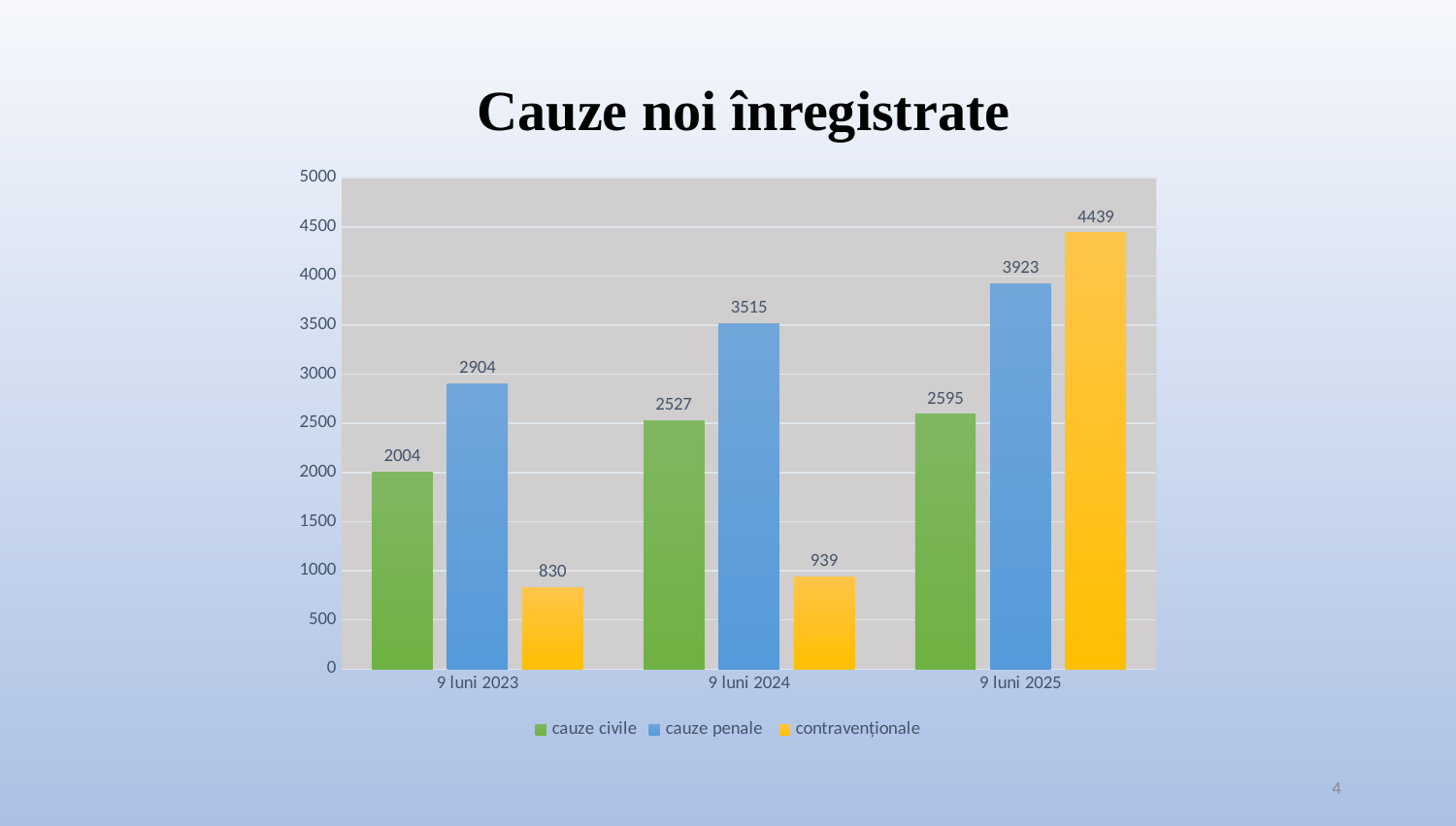
How many periods are shown on the x axis? 3 Which is larger in 9 luni 2024: cauze civile or cauze penale? cauze penale What kind of chart is shown on the slide? bar chart What is the value for cauze penale in 9 luni 2024? 3515 Is the value for contravenționale in 9 luni 2024 greater or less than 1000? less What is the value for cauze civile in 9 luni 2023? 2004 What is the value for contravenționale in 9 luni 2025? 4439 Which period has the highest value for cauze penale? 9 luni 2025 Do the values for cauze civile rise or fall from 9 luni 2023 to 9 luni 2025? rise Which period has the lowest value for contravenționale? 9 luni 2023 What is the difference between cauze penale in 9 luni 2025 and 9 luni 2024? 408 How many series does the legend list? 3